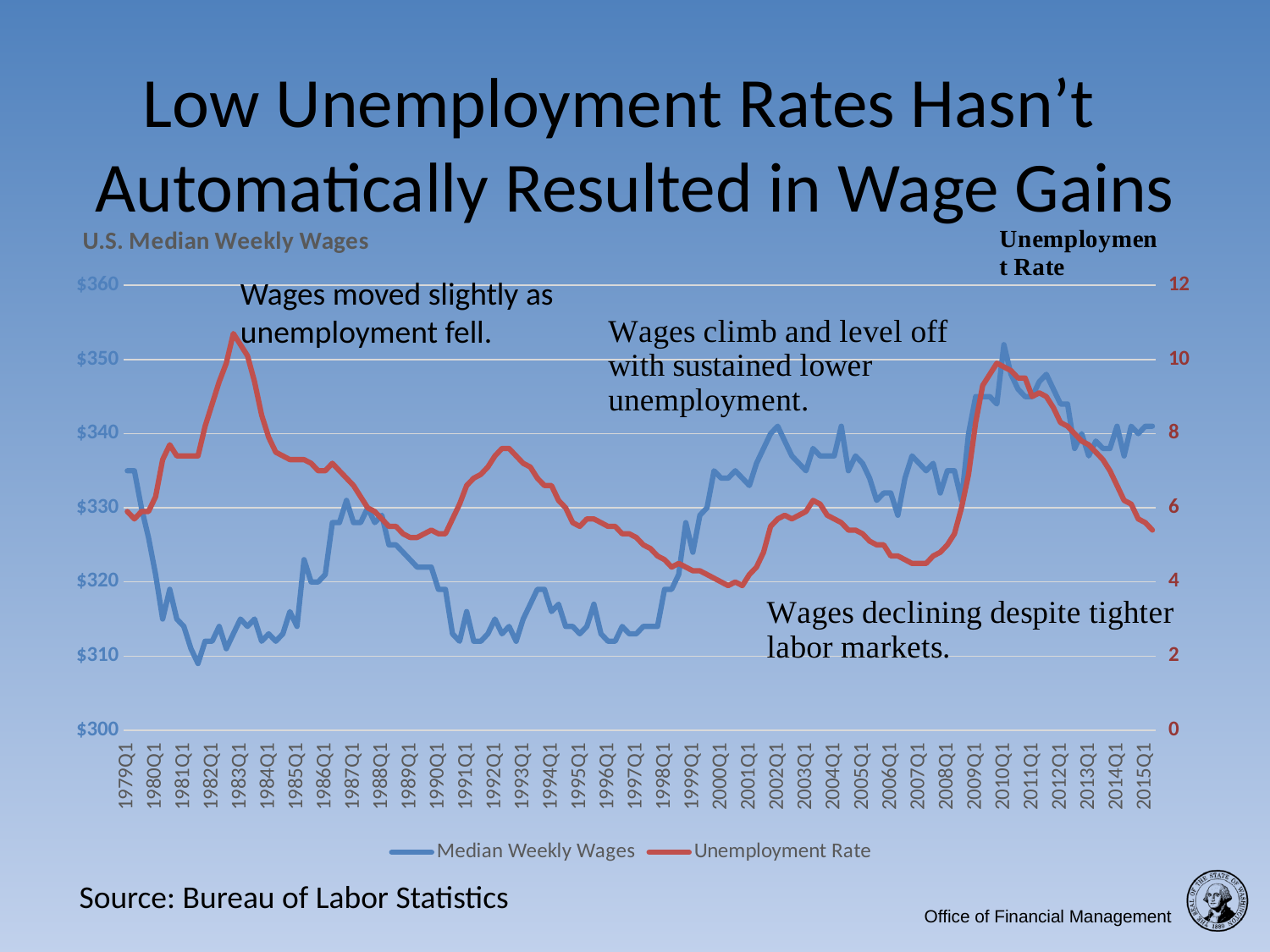
What kind of chart is shown on the slide? line chart In which year do Median Weekly Wages reach their lowest point? 1981 Is the Median Weekly Wages value at 2010Q1 greater or less than $340? greater Is the Unemployment Rate at 2015Q1 greater or less than 6? less What are the two series named in the legend? Median Weekly Wages and Unemployment Rate Which is higher: the Unemployment Rate at 1983Q1 or at 2000Q1? 1983Q1 Does the Unemployment Rate rise or fall from 2010Q1 to 2015Q1? fall Is the Median Weekly Wages value at 1982Q1 greater or less than $320? less What is the title of the left vertical axis? U.S. Median Weekly Wages How many series does the legend list? 2 In which year does the Unemployment Rate reach its highest point? 1982